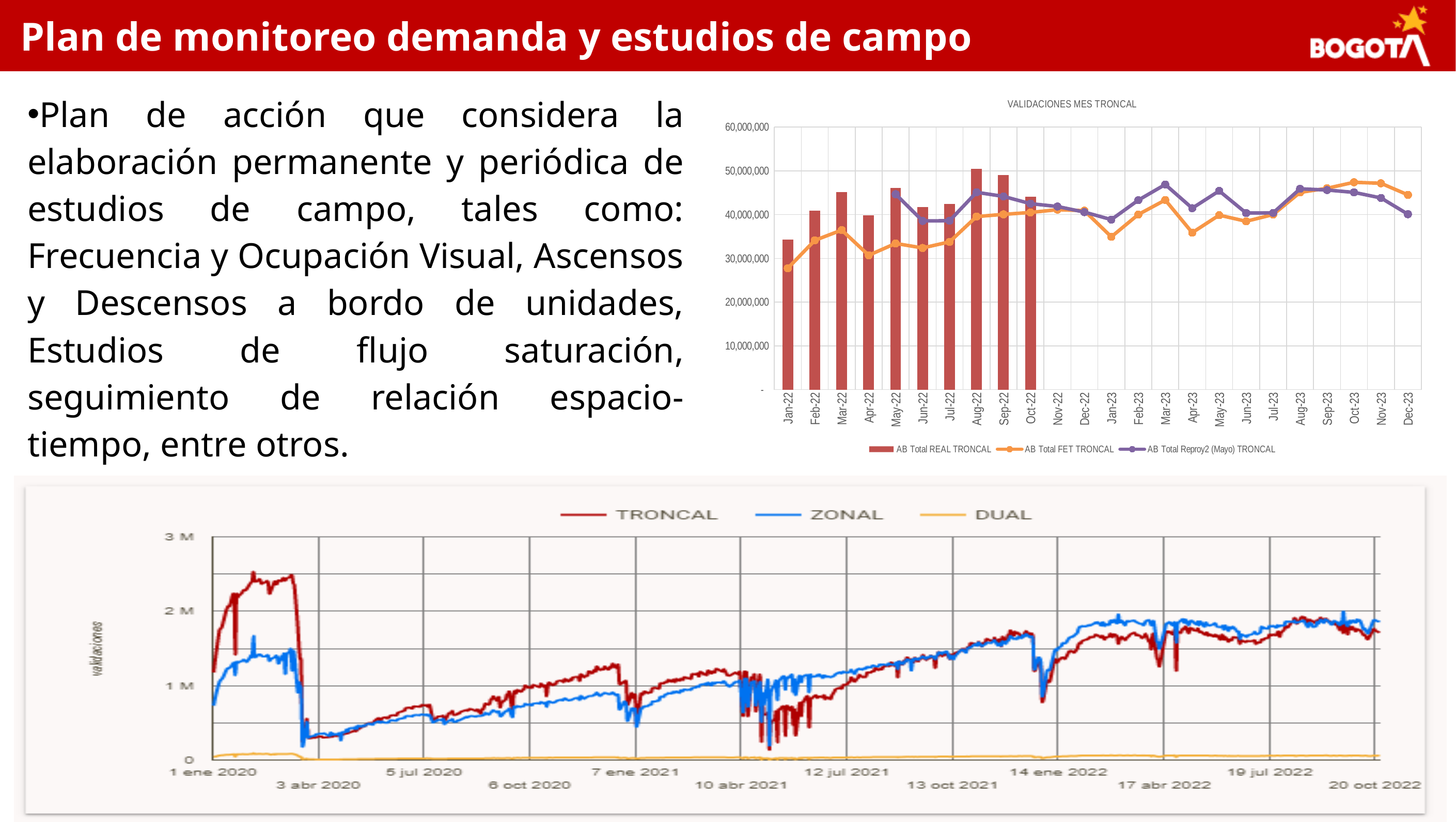
In the 'VALIDACIONES MES TRONCAL' chart, which month has the lowest AB Total REAL TRONCAL bar? Jan-22 In the 'VALIDACIONES MES TRONCAL' chart, which is larger: the AB Total REAL TRONCAL bar for Aug-22 or for Jan-22? Aug-22 In the bottom chart, is the TRONCAL value in early 2020 (before 3 abr 2020) greater or less than 2 M? greater In the bottom chart, which series stays lowest across the whole period? DUAL What kind of chart is the 'VALIDACIONES MES TRONCAL' chart? Combined bar and line chart What kind of chart is the bottom chart with TRONCAL, ZONAL and DUAL? Line chart In the 'VALIDACIONES MES TRONCAL' chart, is the AB Total FET TRONCAL value for Jan-22 greater or less than 30,000,000? less In the 'VALIDACIONES MES TRONCAL' chart, how many months have a bar for AB Total REAL TRONCAL? 10 In the 'VALIDACIONES MES TRONCAL' chart, what is the last month shown on the x axis? Dec-23 In the 'VALIDACIONES MES TRONCAL' chart, how many series does the legend list? 3 In the 'VALIDACIONES MES TRONCAL' chart, is the AB Total Reproy2 (Mayo) TRONCAL value for Mar-23 greater or less than 40,000,000? greater